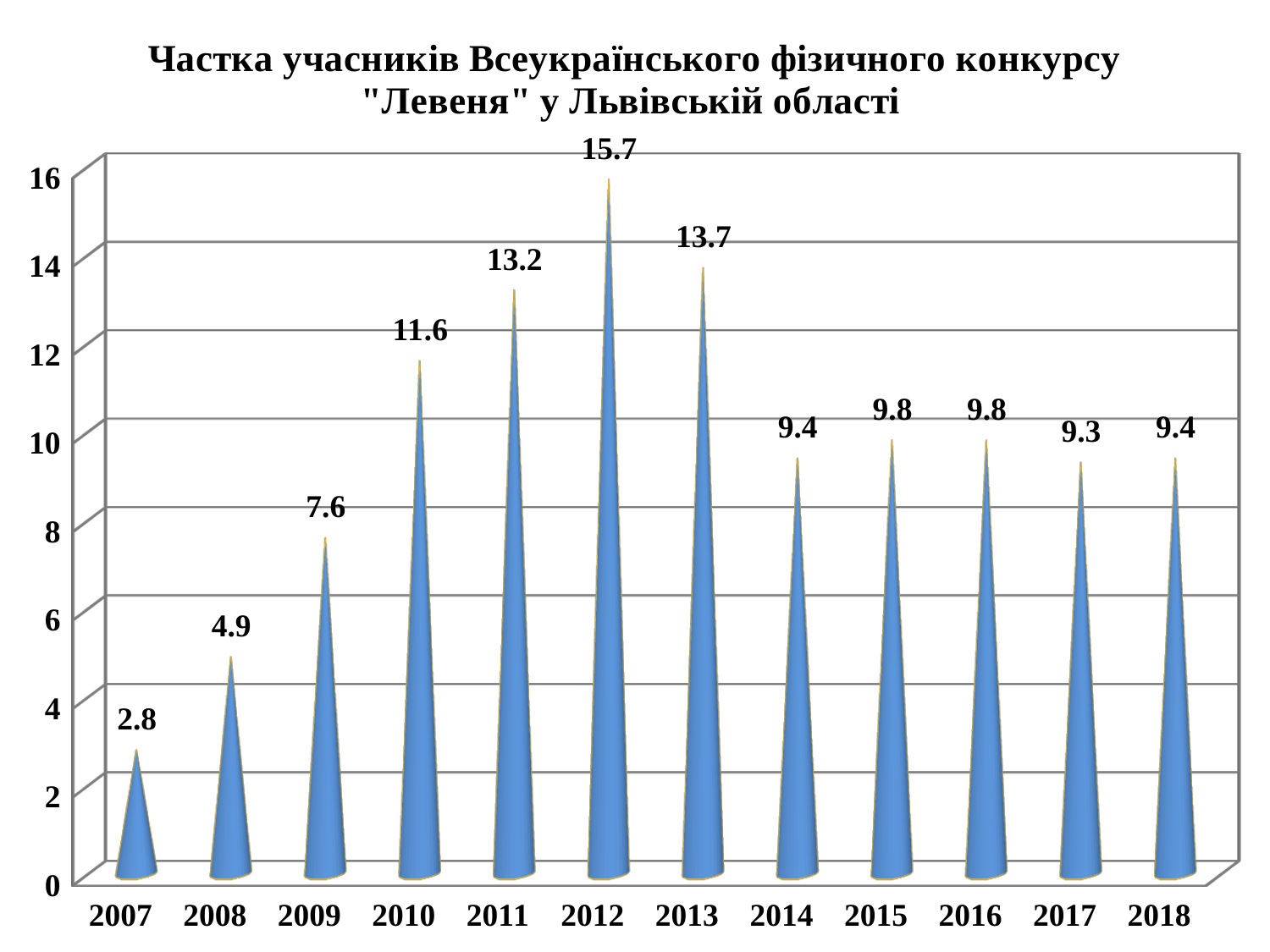
What is the value for 2007? 2.8 What is the difference between the values for 2012 and 2013? 2 What kind of chart is this? bar chart Which year has the highest value? 2012 Which is larger, the value for 2011 or the value for 2014? 2011 How many years are shown on the x axis? 12 Do the values rise or fall from 2007 to 2012? rise What is the value for 2017? 9.3 Is the value for 2013 greater or less than 12? greater Which year has the lowest value? 2007 What is the value for 2012? 15.7 What is the difference between the values for 2010 and 2009? 4